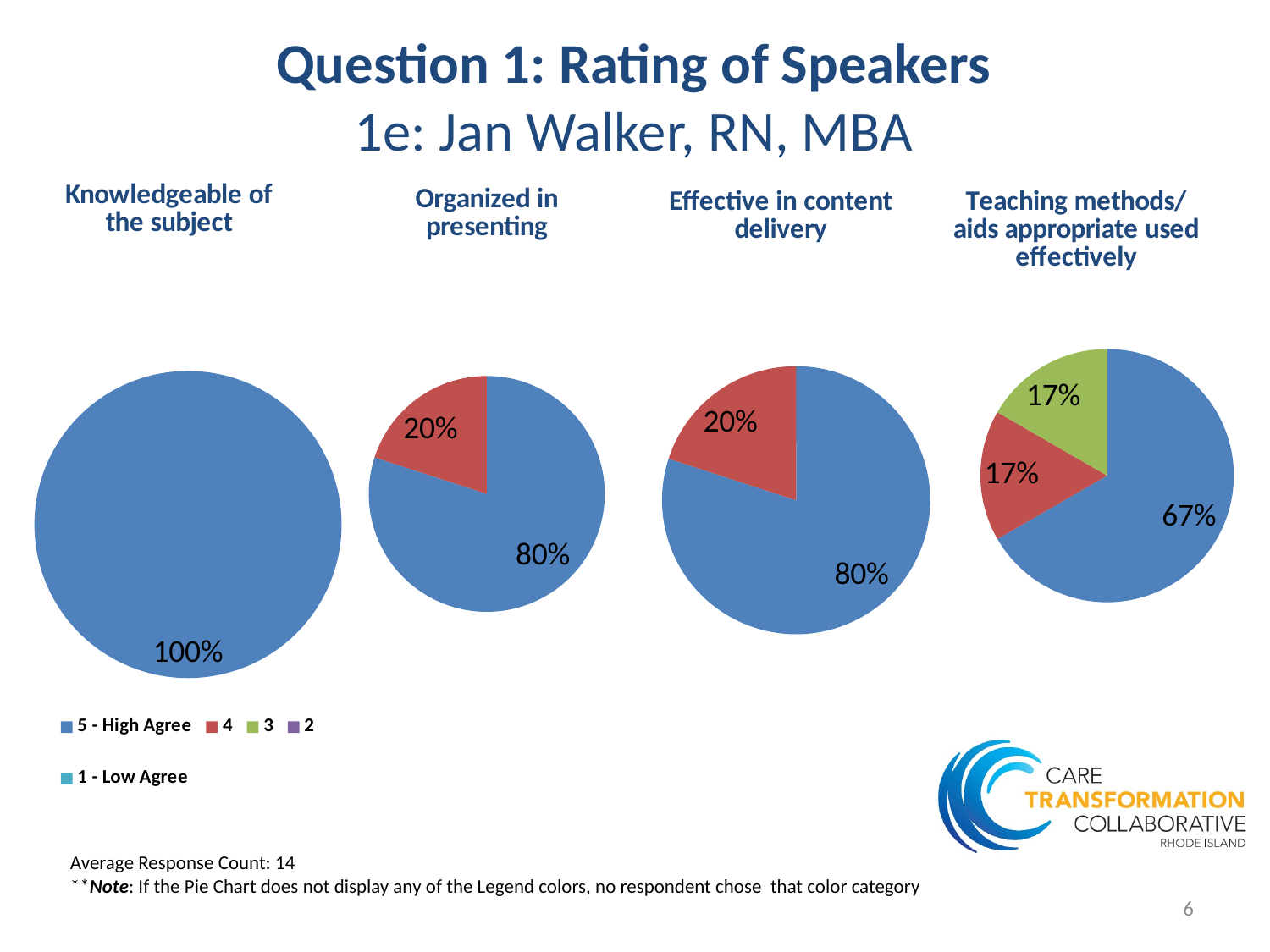
In the 'Effective in content delivery' pie chart, what share is labelled for '5 - High Agree'? 80% In the 'Organized in presenting' pie chart, what share is labelled for '5 - High Agree'? 80% In the 'Knowledgeable of the subject' pie chart, what share is labelled for '5 - High Agree'? 100% Which pie chart has the smallest share for '5 - High Agree'? Teaching methods/aids appropriate used effectively In the 'Teaching methods/aids appropriate used effectively' pie chart, which rating has the largest slice? 5 - High Agree What kind of chart is used on this slide? Pie chart In the 'Organized in presenting' pie chart, what is the difference between the '5 - High Agree' share and the '4' share? 60% How many entries does the legend list? 5 How many pie charts are shown on the slide? 4